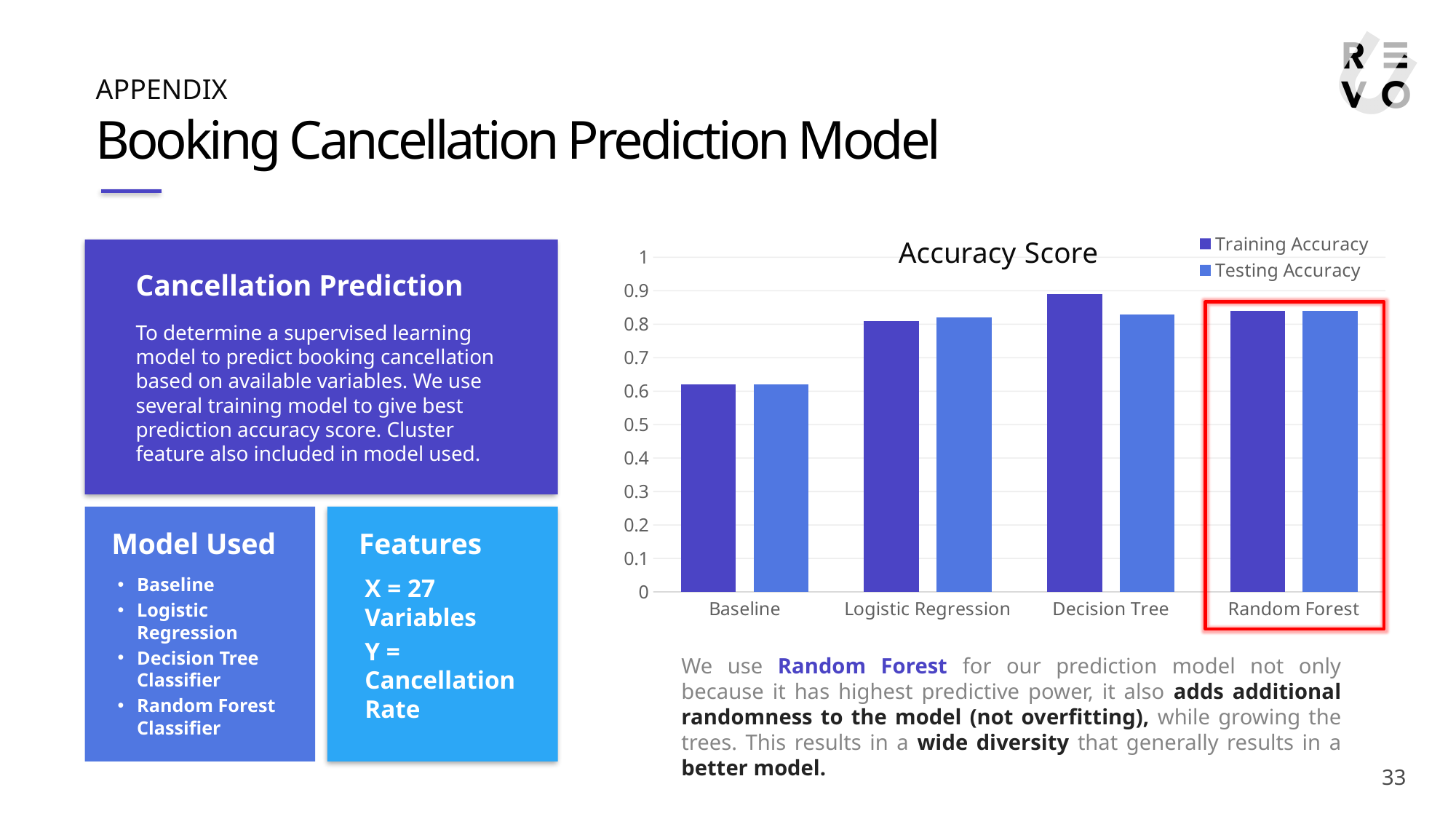
Which category has the lowest Testing Accuracy? Baseline For Decision Tree, which is larger: Training Accuracy or Testing Accuracy? Training Accuracy Which category has the lowest Training Accuracy? Baseline Which category has the highest Training Accuracy? Decision Tree How many categories are shown on the x axis of the Accuracy Score chart? 4 What is the title of the chart? Accuracy Score How many series does the legend of the Accuracy Score chart list? 2 Is the Testing Accuracy for Random Forest greater or less than 0.8? greater Is the Testing Accuracy for Baseline greater or less than 0.7? less What kind of chart is shown on the slide? bar chart Does Training Accuracy rise or fall from Baseline to Logistic Regression? rise Is the Training Accuracy for Baseline greater or less than 0.5? greater